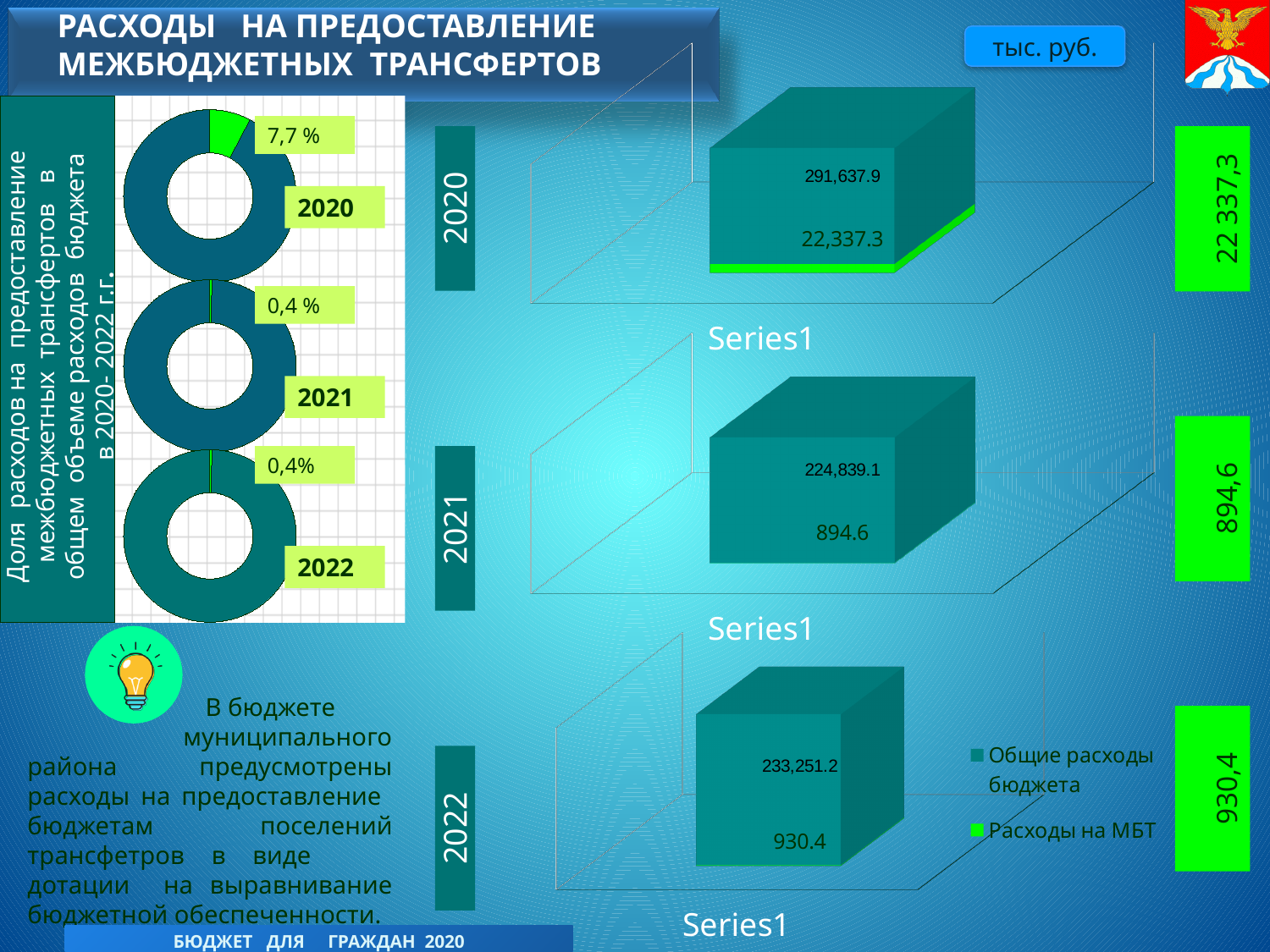
In the 2020 donut chart on the left, what share of total budget expenditure is shown for intergovernmental transfers? 7,7 % In the 2021 donut chart on the left, what share is shown for intergovernmental transfers? 0,4 % In the 2020 bar chart, what is the value labelled for total budget expenditure (Общие расходы бюджета)? 291,637.9 In the 2022 bar chart, what is the value labelled for total budget expenditure? 233,251.2 In the 2021 bar chart, what is the value labelled for total budget expenditure? 224,839.1 In the 2021 bar chart, what is the value labelled for expenditure on intergovernmental transfers (МБТ)? 894.6 How many series does the legend of the bar charts on the right list? 2 Which year's bar chart shows the highest value for expenditure on intergovernmental transfers (МБТ): 2020, 2021 or 2022? 2020 In the 2022 bar chart, what is the value labelled for expenditure on intergovernmental transfers (МБТ)? 930.4 Which year's bar chart shows the lowest value for total budget expenditure: 2020, 2021 or 2022? 2021 In the 2020 bar chart, what is the value labelled for expenditure on intergovernmental transfers (Расходы на МБТ)? 22,337.3 What type of chart is used for the three charts on the left side of the slide showing 7,7 %, 0,4 % and 0,4%? Donut (pie) chart